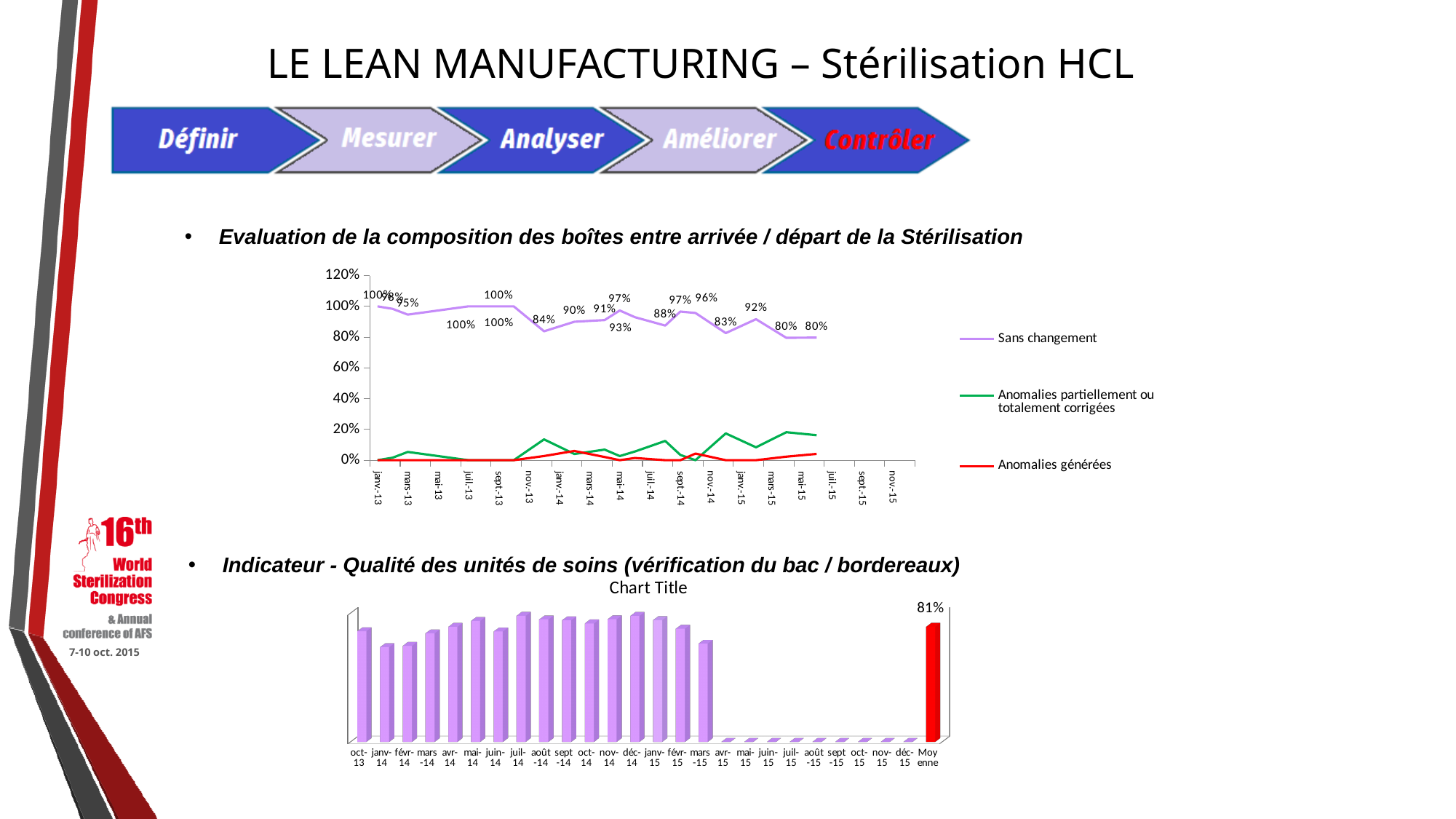
In the bottom bar chart, which bar is larger: juil-14 or janv-14? juil-14 In the top line chart, is the value of the Anomalies générées series at mai-15 greater or less than 20%? less In the bottom bar chart, what is the value of the Moyenne bar? 81% In the top line chart, how many series does the legend list? 3 In the top line chart, what is the lowest labelled value of the Sans changement series? 80% In the top line chart, is the value of the Sans changement series at janv-13 greater or less than 80%? greater What kind of chart is the bottom chart titled 'Chart Title'? bar chart In the top line chart, what is the value of the Sans changement series at mai-15? 80% In the bottom bar chart, what colour is the Moyenne bar? red In the top line chart, which series is drawn in green? Anomalies partiellement ou totalement corrigées In the top line chart, which series has the highest values across the whole period? Sans changement In the top line chart, what is the highest labelled value of the Sans changement series? 100%